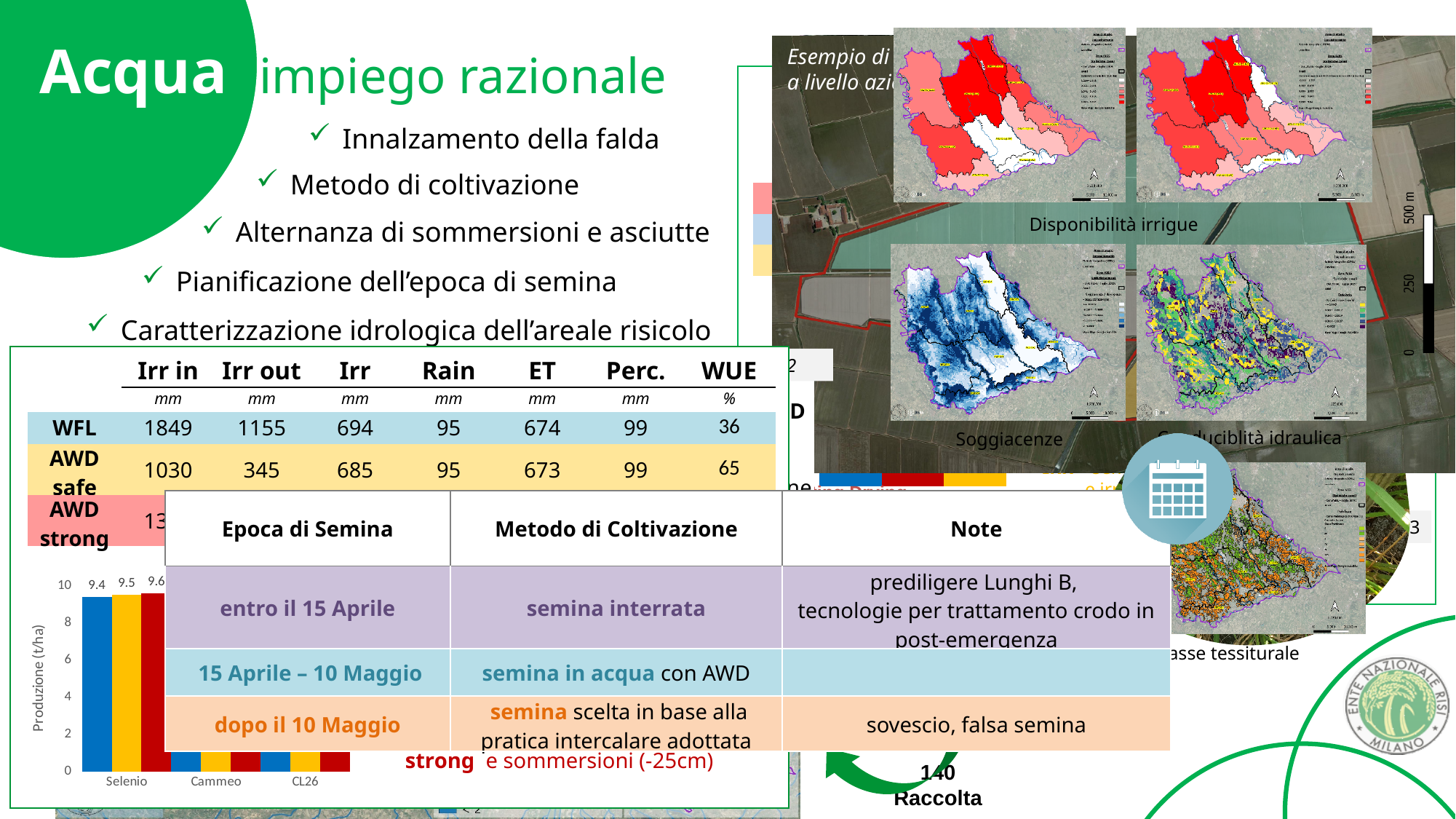
What kind of chart is shown at the bottom left of the slide? bar chart In the bar chart at the bottom left, which coloured bar for Selenio has the highest value? red What is the label of the y axis of the bar chart at the bottom left? Produzione (t/ha) In the bar chart at the bottom left, what is the difference between the red bar and the blue bar for Selenio? 0.2 In the bar chart at the bottom left, what is the value of the red bar for Selenio? 9.6 In the bar chart at the bottom left, what is the value of the yellow bar for Selenio? 9.5 What is the highest tick value shown on the y axis of the bar chart at the bottom left? 10 In the bar chart at the bottom left, is the value of the blue bar for Selenio greater or less than 8? greater In the bar chart at the bottom left, what is the value of the blue bar for Selenio? 9.4 In the bar chart at the bottom left, is the red bar for Selenio larger or smaller than the yellow bar for Selenio? larger In the bar chart at the bottom left, which coloured bar for Selenio has the lowest value? blue How many categories are shown on the x axis of the bar chart at the bottom left? 3